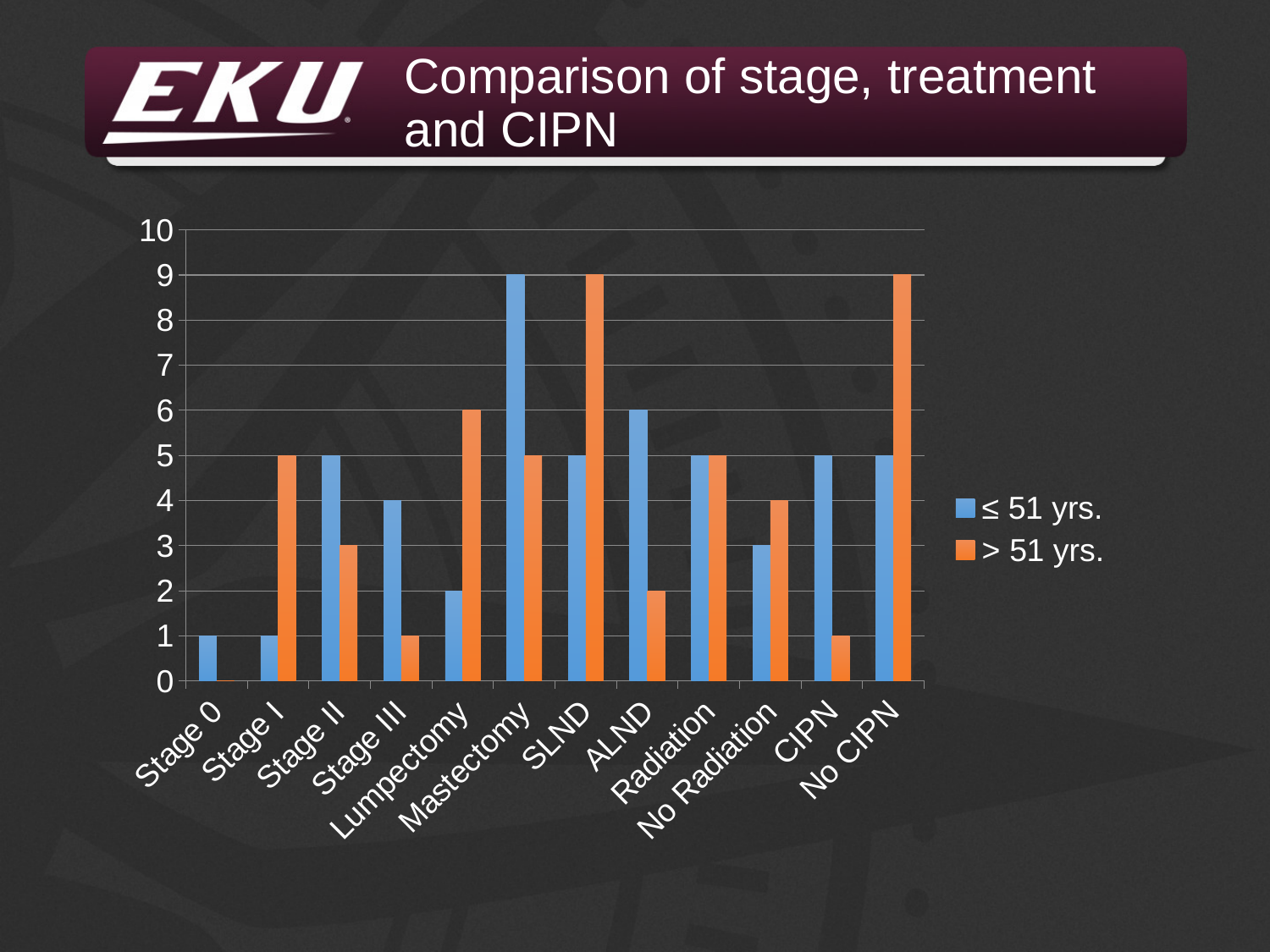
What is the difference between the > 51 yrs. and ≤ 51 yrs. values for No CIPN? 4 For CIPN, which series has the larger value, ≤ 51 yrs. or > 51 yrs.? ≤ 51 yrs. What type of chart is shown on the slide? bar chart How many categories are shown on the x axis? 12 Is the value for SLND in the > 51 yrs. series greater or less than 5? greater What is the value for Mastectomy in the ≤ 51 yrs. series? 9 What is the title of the slide? Comparison of stage, treatment and CIPN Which category has the lowest value in the > 51 yrs. series? Stage 0 How many series does the legend list? 2 Which category has the highest value in the ≤ 51 yrs. series? Mastectomy What is the value for Lumpectomy in the > 51 yrs. series? 6 What is the value for ALND in the ≤ 51 yrs. series? 6